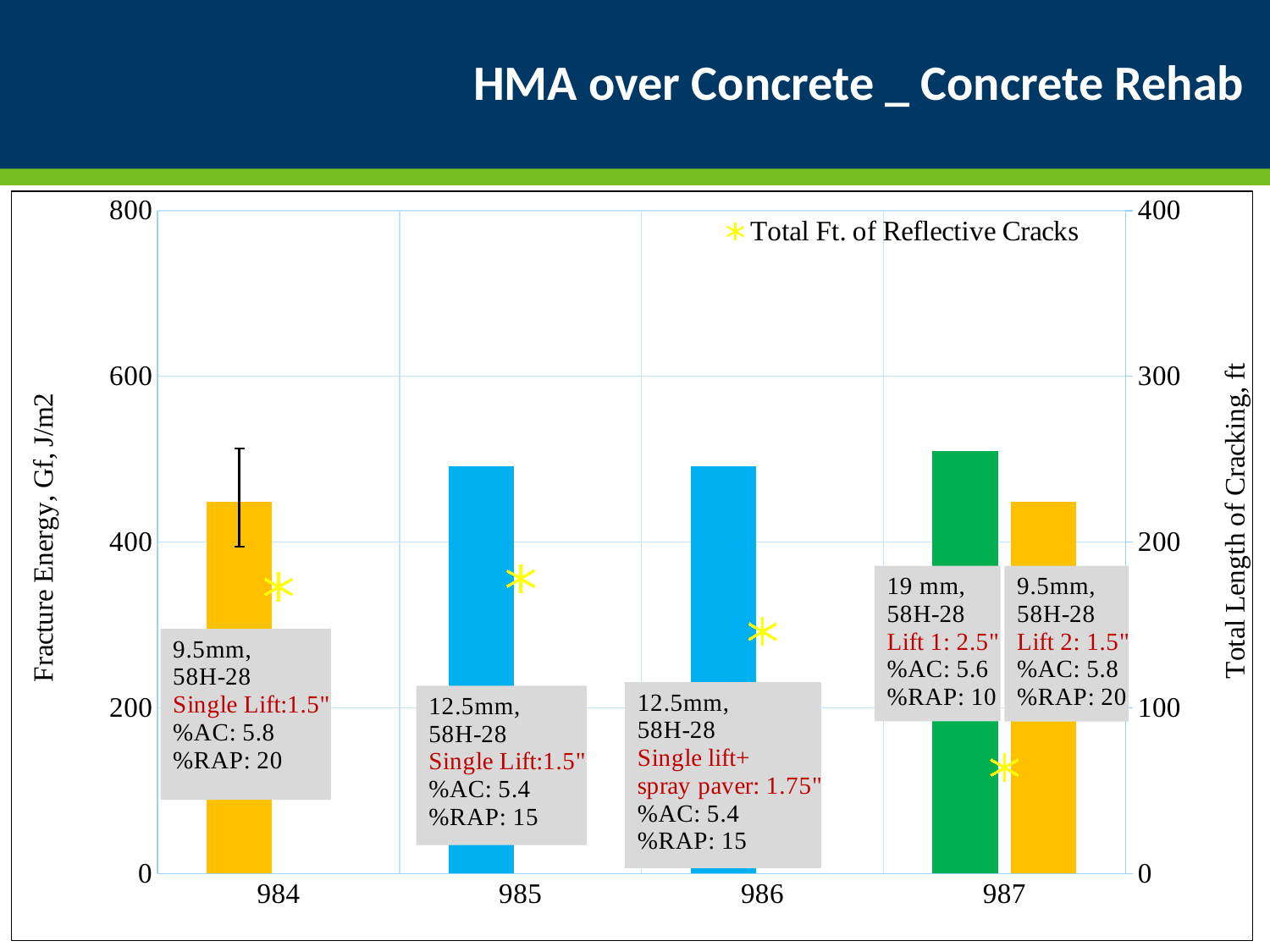
What kind of chart is shown on the slide? combination bar and line chart How many categories are shown on the x axis? 4 Is the Total Ft. of Reflective Cracks marker for 986 greater or less than 200 on the right axis? less Is the fracture energy bar for 984 greater or less than 400? greater Which category has the lowest Total Ft. of Reflective Cracks marker? 987 What is the title of the left vertical axis? Fracture Energy, Gf, J/m2 Is the fracture energy bar for 986 greater or less than 400? greater Which has the higher fracture energy bar, 984 or 985? 985 What series does the star marker in the legend represent? Total Ft. of Reflective Cracks